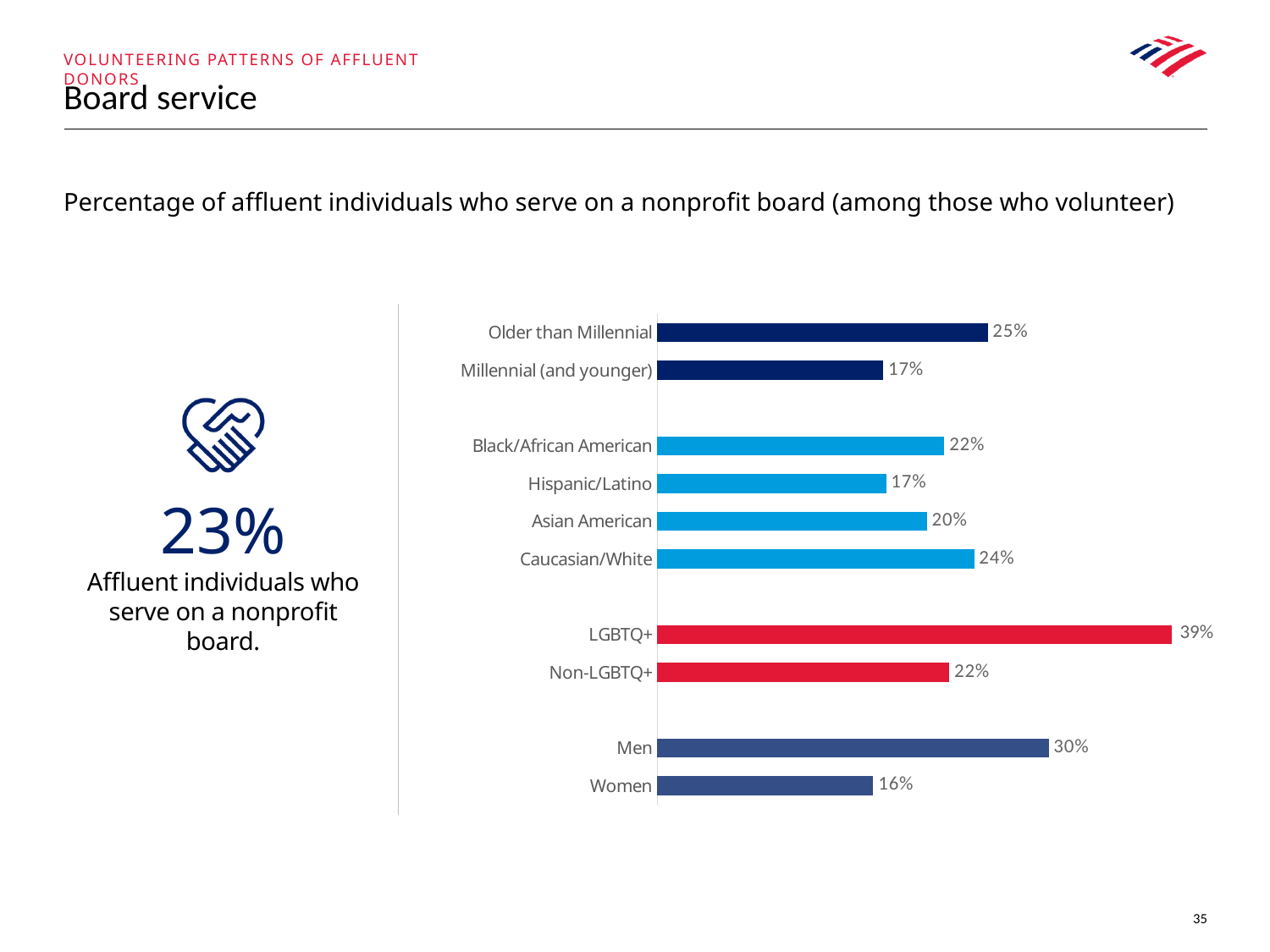
What kind of chart is shown on the slide? Bar chart What is the value shown for Women? 16% How many categories are plotted in the chart? 10 What is the difference between the values for Men and Women? 14% Which is larger, the value for Black/African American or the value for Hispanic/Latino? Black/African American What percentage of affluent individuals overall serve on a nonprofit board, according to the callout on the left? 23% Which category has the lowest percentage serving on a nonprofit board? Women What is the difference between the values for LGBTQ+ and Non-LGBTQ+? 17% What is the value shown for Older than Millennial? 25% What is the value shown for Asian American? 20% Which category has the highest percentage serving on a nonprofit board? LGBTQ+ What percentage of LGBTQ+ affluent individuals serve on a nonprofit board? 39%